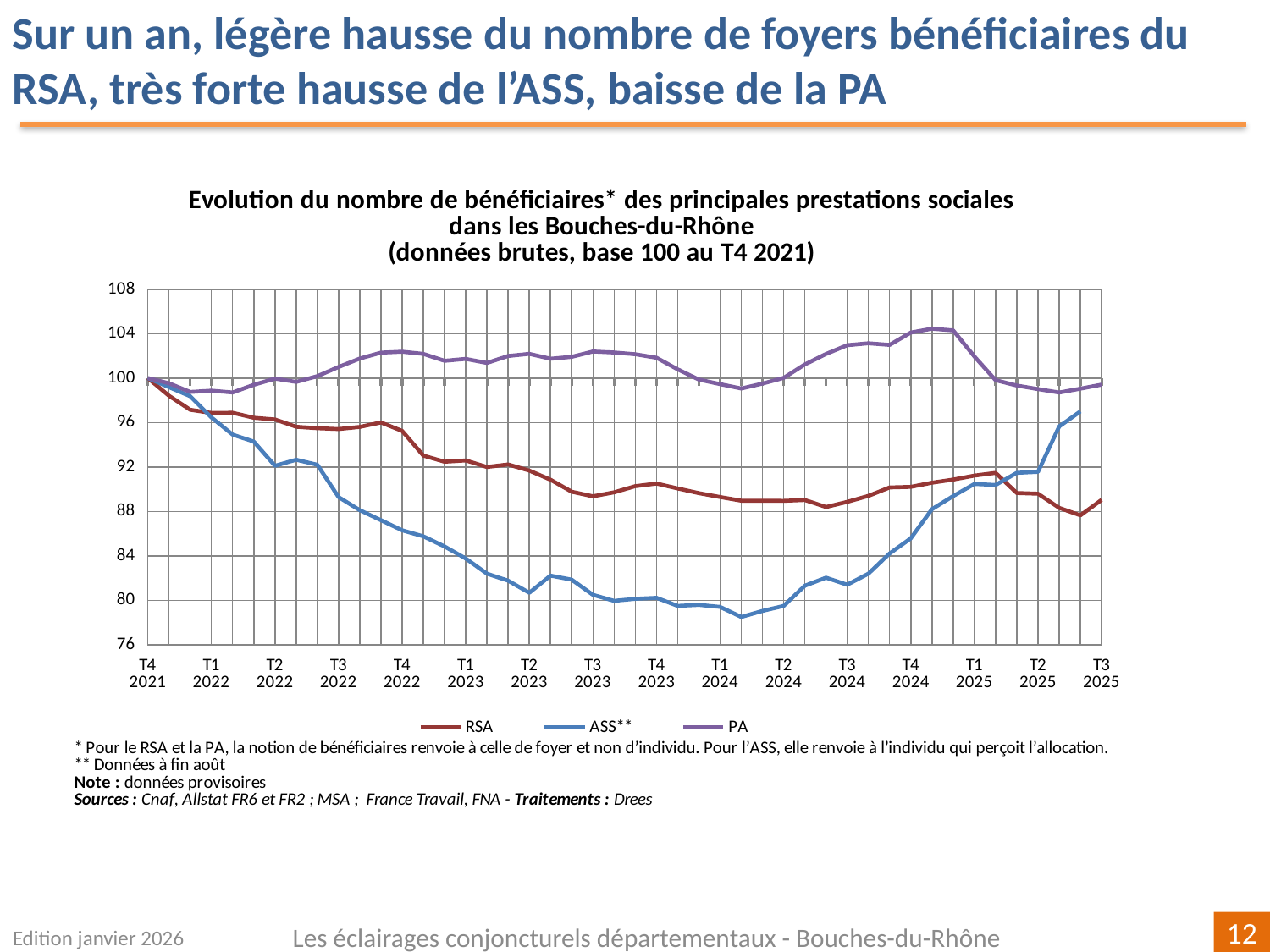
How many series does the legend list? 3 What kind of chart is shown on the slide? line chart Which series are listed in the legend? RSA, ASS**, PA Is the value for RSA at T3 2025 greater or less than 92? less Is the value for ASS** at T1 2024 greater or less than 80? less Is the value for PA at T3 2024 greater or less than 100? greater At T4 2024, which series has the highest value? PA What is the base period (base 100) stated in the chart title? T4 2021 Does the ASS** series rise or fall between T4 2021 and T1 2024? fall At T1 2024, which series has the lowest value? ASS**